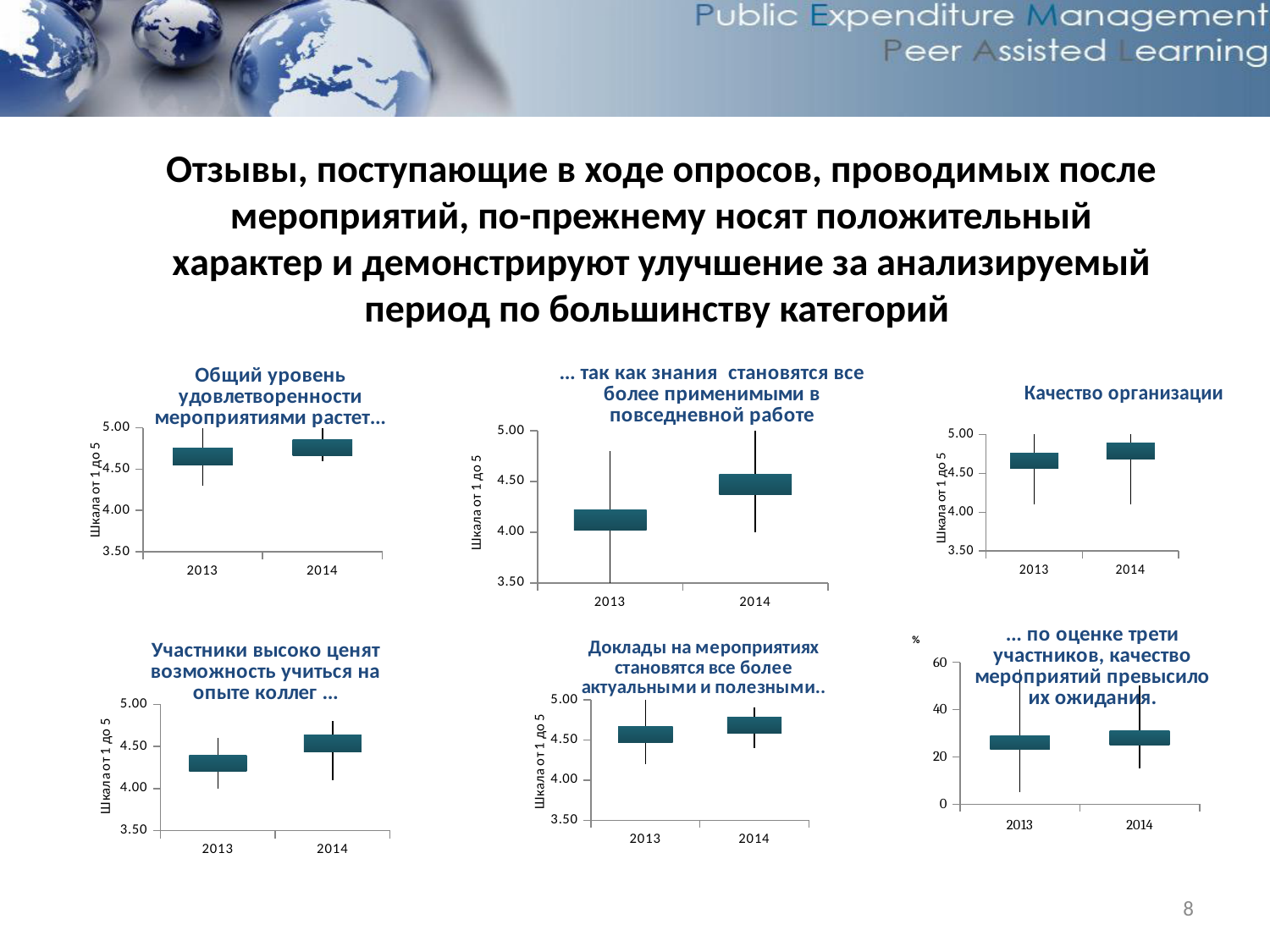
How many charts are shown on the slide? 6 On the chart titled "... по оценке трети участников, качество мероприятий превысило их ожидания.", is the value for 2014 greater or less than 20? greater On the chart titled "... по оценке трети участников, качество мероприятий превысило их ожидания.", is the value for 2013 greater or less than 40? less On the chart titled "... так как знания становятся все более применимыми в повседневной работе", is the value for 2013 greater or less than 4.50? less On the chart titled "Общий уровень удовлетворенности мероприятиями растет...", do the values rise or fall from 2013 to 2014? rise On the chart titled "Общий уровень удовлетворенности мероприятиями растет...", how many years are shown on the x axis? 2 On the chart titled "... так как знания становятся все более применимыми в повседневной работе", which year has the higher value, 2013 or 2014? 2014 What is the y-axis label on the chart titled "Качество организации"? Шкала от 1 до 5 On the chart titled "Участники высоко ценят возможность учиться на опыте коллег ...", do the values rise or fall from 2013 to 2014? rise